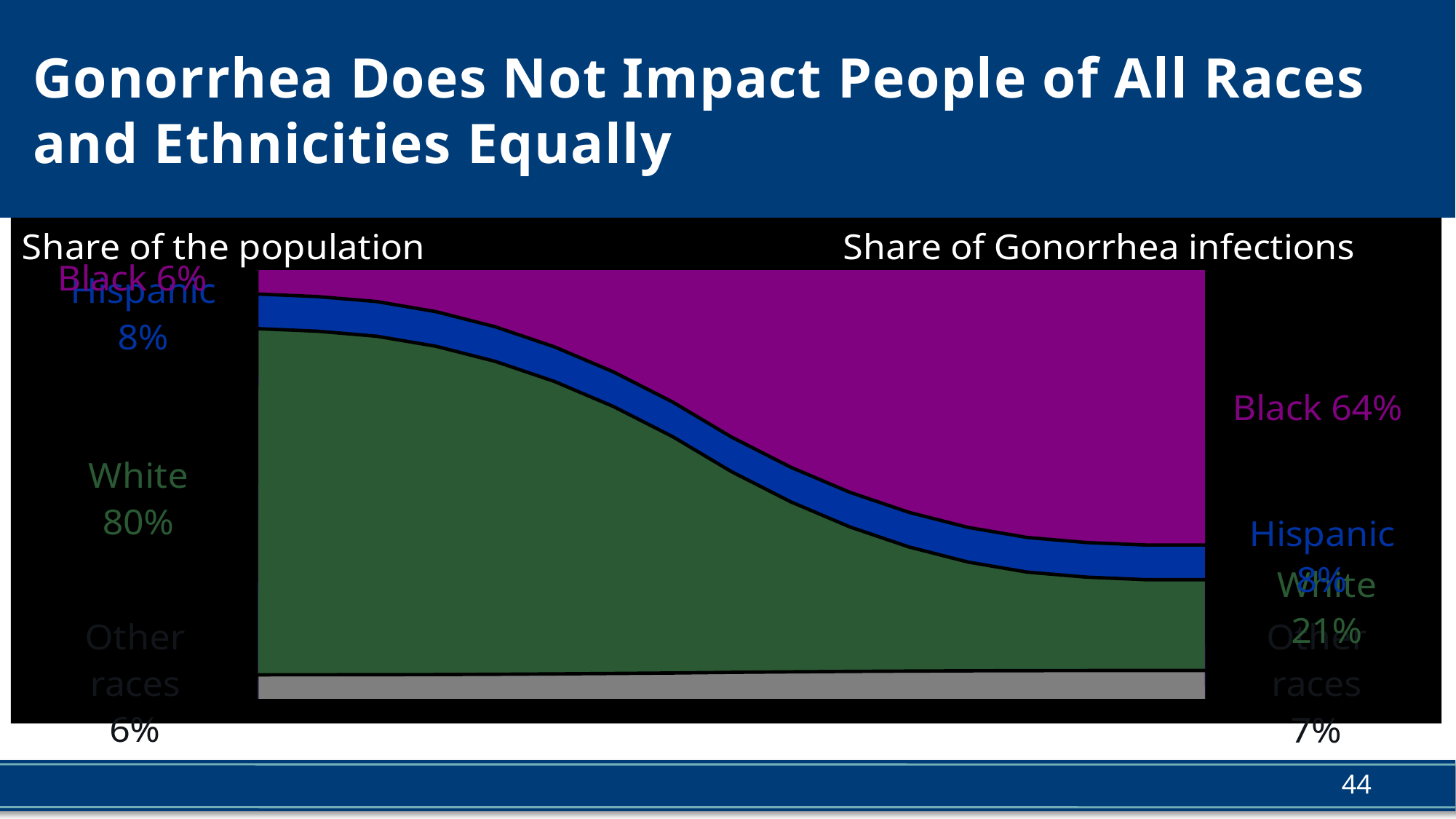
Which is larger: the White share of the population or the White share of Gonorrhea infections? White share of the population What share of Gonorrhea infections is attributed to Hispanic people? 8% By how many percentage points does the Black share of Gonorrhea infections exceed the Black share of the population? 58 percentage points What share of the population is White? 80% What share of Gonorrhea infections is attributed to White people? 21% What share of Gonorrhea infections is attributed to Black people? 64% What share of Gonorrhea infections is attributed to Other races? 7% Which group has the largest share of the population? White How many racial/ethnic groups are shown in the chart? 4 Which group has the largest share of Gonorrhea infections? Black What kind of chart is shown on the slide? Stacked area chart What share of the population is Black according to the chart? 6%